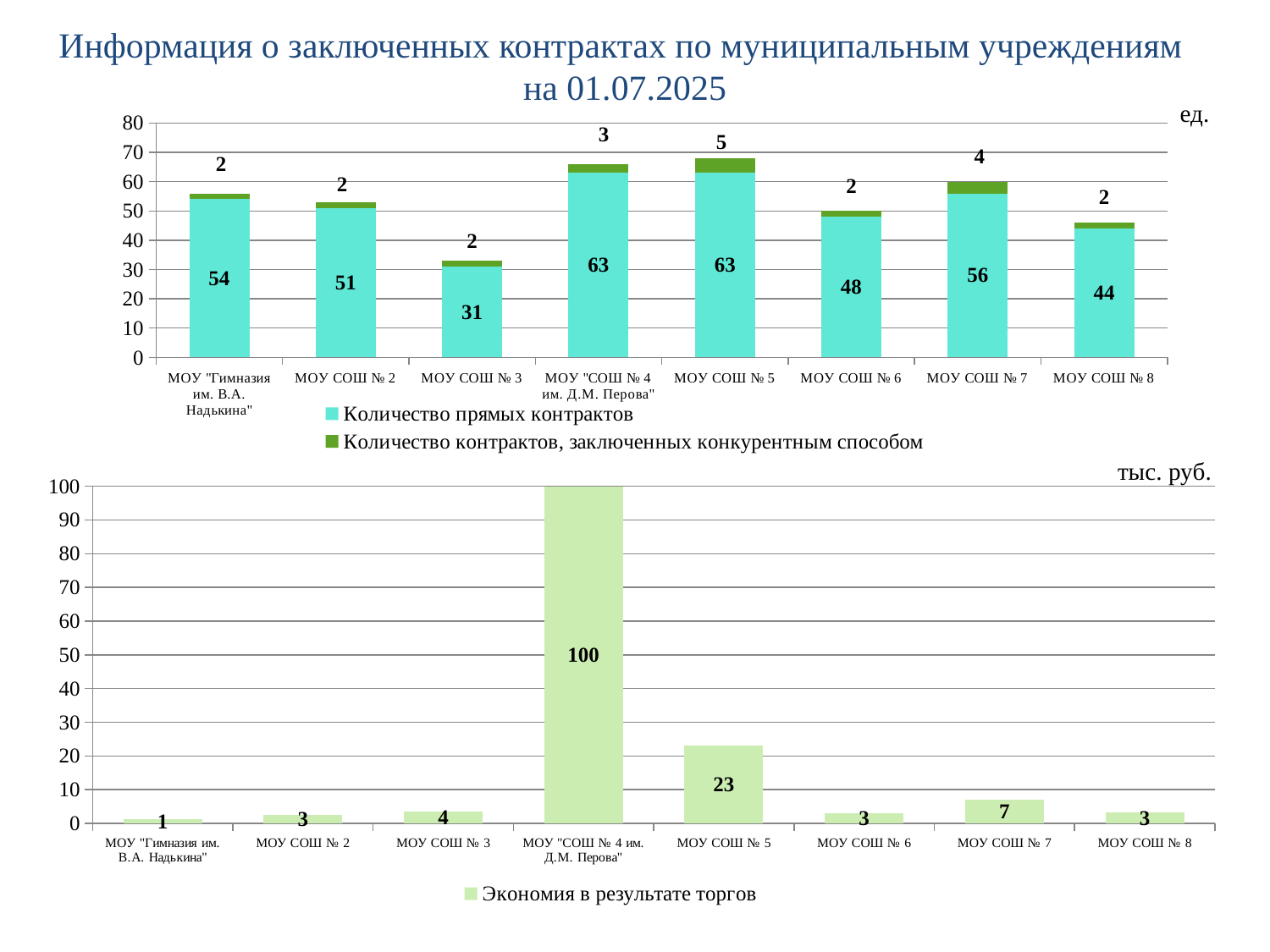
In the top chart, how many direct contracts (Количество прямых контрактов) does МОУ СОШ № 3 have? 31 In the bottom chart (Экономия в результате торгов), which institution has the highest savings? МОУ "СОШ № 4 им. Д.М. Перова" In the bottom chart, which is larger: the savings for МОУ СОШ № 7 or for МОУ СОШ № 3? МОУ СОШ № 7 In the top chart, how many contracts concluded by competitive method does МОУ СОШ № 5 have? 5 In the top chart, what is the difference in direct contracts between МОУ "Гимназия им. В.А. Надькина" and МОУ СОШ № 8? 10 In the top chart, which institution has the lowest number of direct contracts? МОУ СОШ № 3 In the top chart, how many series does the legend list? 2 How many institutions are shown on the x axis of the bottom chart? 8 In the top chart, what is the total number of contracts (both series) for МОУ СОШ № 7? 60 In the bottom chart, what is the savings value for МОУ СОШ № 5? 23 What type of chart is the bottom chart? Bar chart In the bottom chart, which institution has the lowest savings? МОУ "Гимназия им. В.А. Надькина"